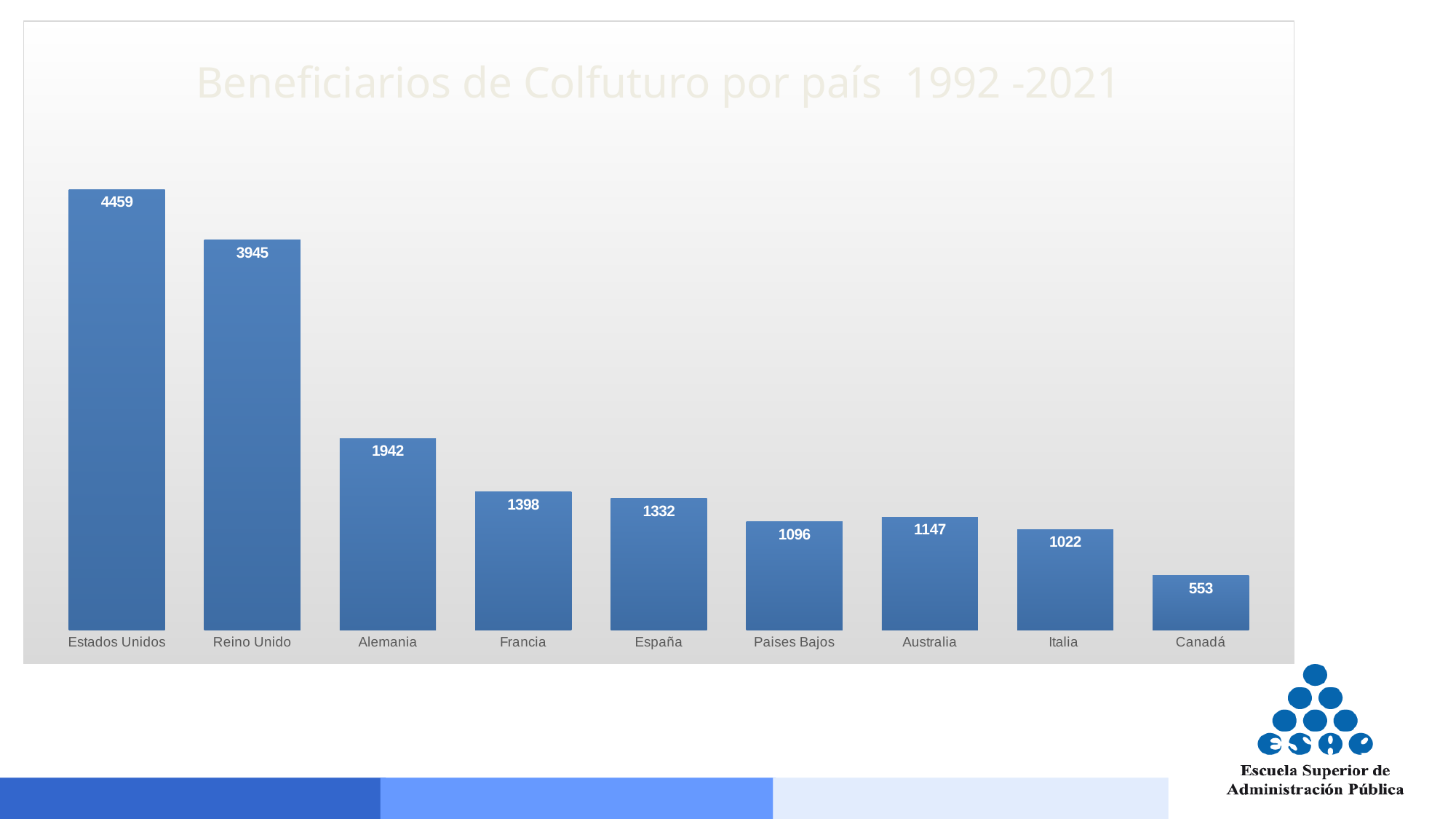
What is the difference between the values for Francia and España? 66 What is the value for Estados Unidos? 4459 Which country has the highest value? Estados Unidos Which country has the lowest value? Canadá What is the value for Alemania? 1942 How many countries are shown in the chart? 9 What kind of chart is shown on the slide? Bar chart What is the title of the chart? Beneficiarios de Colfuturo por país 1992 -2021 What is the difference between the values for Estados Unidos and Reino Unido? 514 What is the value for Paises Bajos? 1096 Which is larger, the value for Australia or the value for Italia? Australia What is the value for Canadá? 553